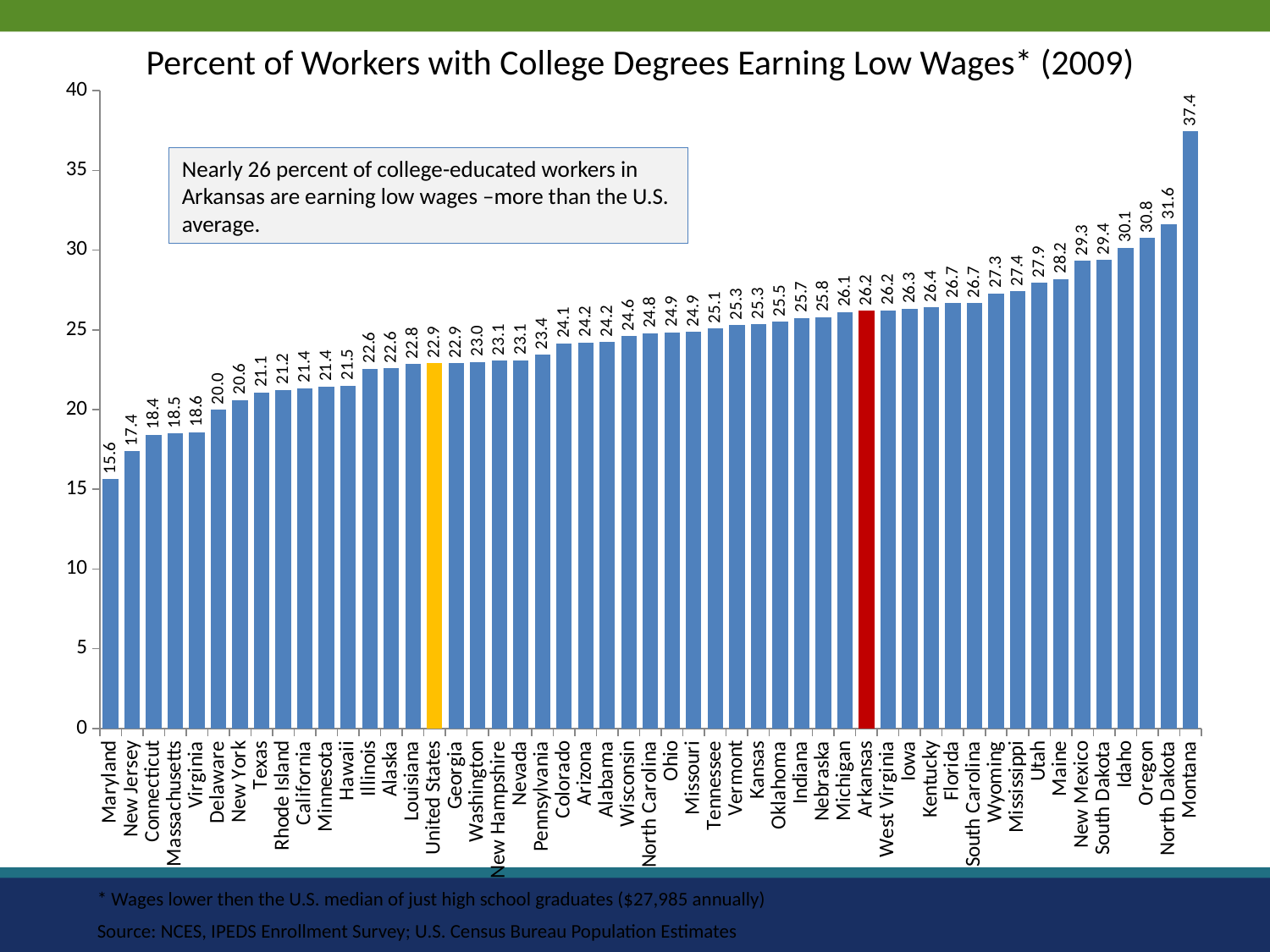
What is the difference between the value for Arkansas and the value for the United States? 3.3 Is the value for Montana greater or less than 35? greater Do the values rise or fall moving from left to right along the x axis? Rise What is the value for Maine? 28.2 Which is larger, the value for Texas or the value for Idaho? Idaho What kind of chart is shown on the slide? Bar chart What is the value for the United States bar? 22.9 What colour is the bar for Arkansas? Red How many bars are plotted in the chart? 51 Which category has the lowest value? Maryland What is the value for Arkansas? 26.2 Which category has the highest value? Montana